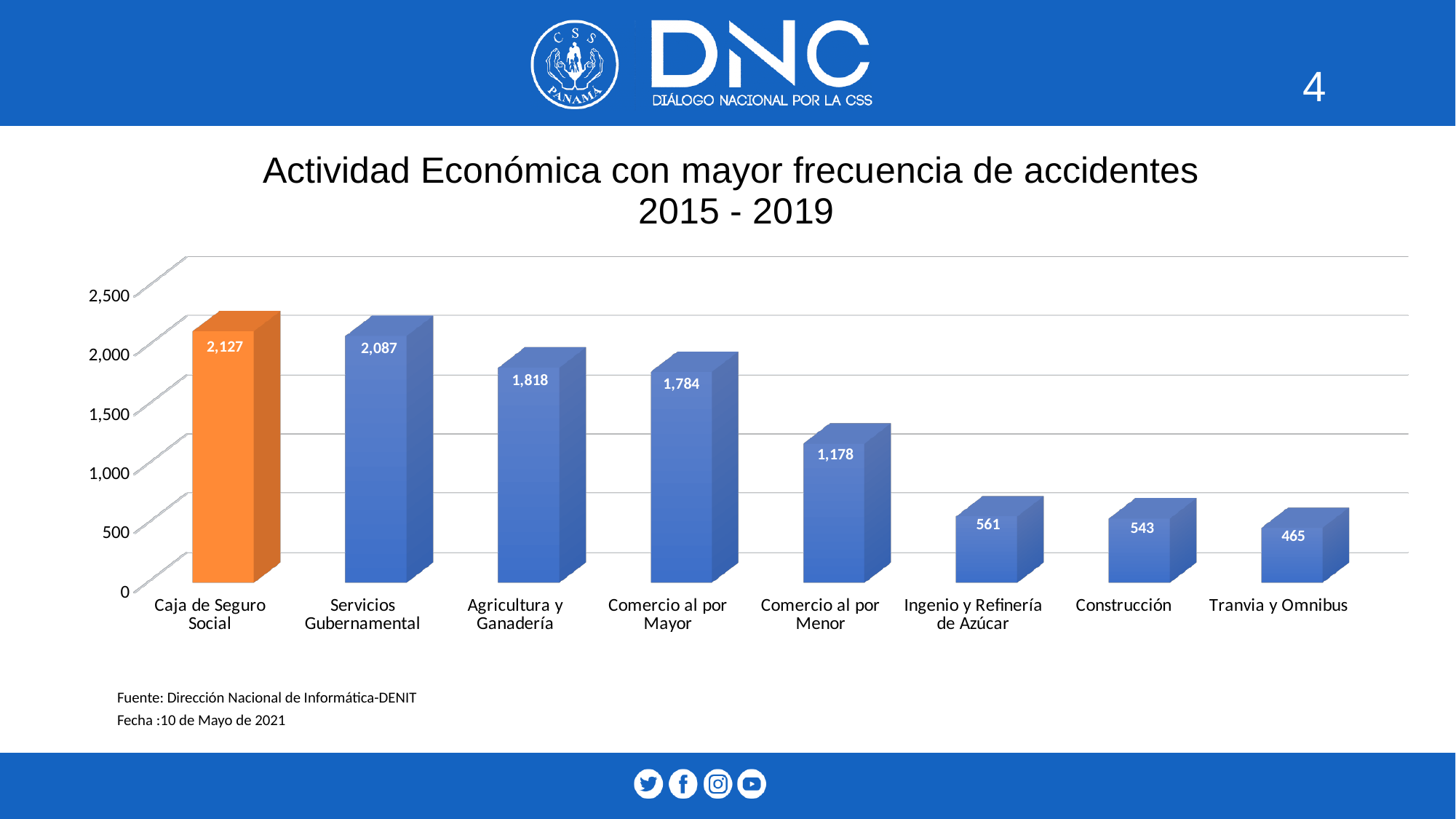
Which category has the highest value? Caja de Seguro Social Which is larger, the value for Ingenio y Refinería de Azúcar or the value for Tranvia y Omnibus? Ingenio y Refinería de Azúcar What is the difference between the values for Caja de Seguro Social and Servicios Gubernamental? 40 Which bar is coloured orange instead of blue? Caja de Seguro Social What is the difference between the values for Agricultura y Ganadería and Comercio al por Menor? 640 Which category has the lowest value? Tranvia y Omnibus What is the value for Caja de Seguro Social? 2,127 Is the value for Comercio al por Mayor greater or less than 1,500? greater What is the value for Construcción? 543 How many categories are shown on the chart? 8 What kind of chart is shown on the slide? bar chart What is the value for Comercio al por Menor? 1,178